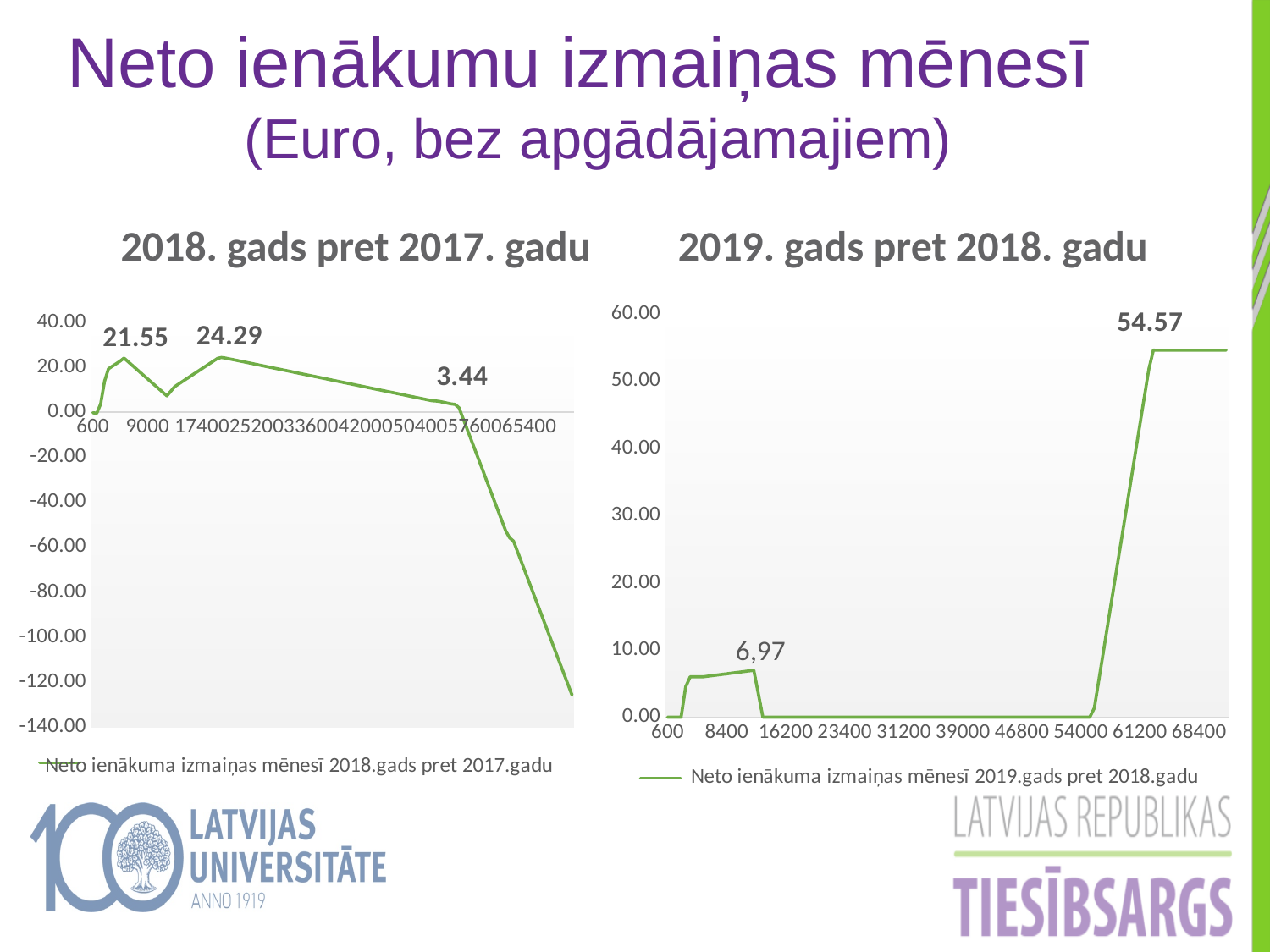
In the '2018. gads pret 2017. gadu' chart, what is the first labelled value near the start of the line? 21.55 In the '2018. gads pret 2017. gadu' chart, does the line rise or fall between 57600 and 65400? fall In the '2019. gads pret 2018. gadu' chart, is the value at 39000 greater or less than 10.00? less In the '2019. gads pret 2018. gadu' chart, what is the highest labelled value? 54.57 In the '2018. gads pret 2017. gadu' chart, what is the highest labelled value? 24.29 How many series does the legend of the '2019. gads pret 2018. gadu' chart list? 1 In the '2018. gads pret 2017. gadu' chart, what is the labelled value just before the line drops below zero? 3.44 In the '2019. gads pret 2018. gadu' chart, what is the labelled value near the start of the line? 6,97 In the '2019. gads pret 2018. gadu' chart, which labelled value is larger, 6,97 or 54.57? 54.57 What kind of chart is the '2018. gads pret 2017. gadu' chart? line chart In the '2018. gads pret 2017. gadu' chart, what is the difference between the labelled values 24.29 and 21.55? 2.74